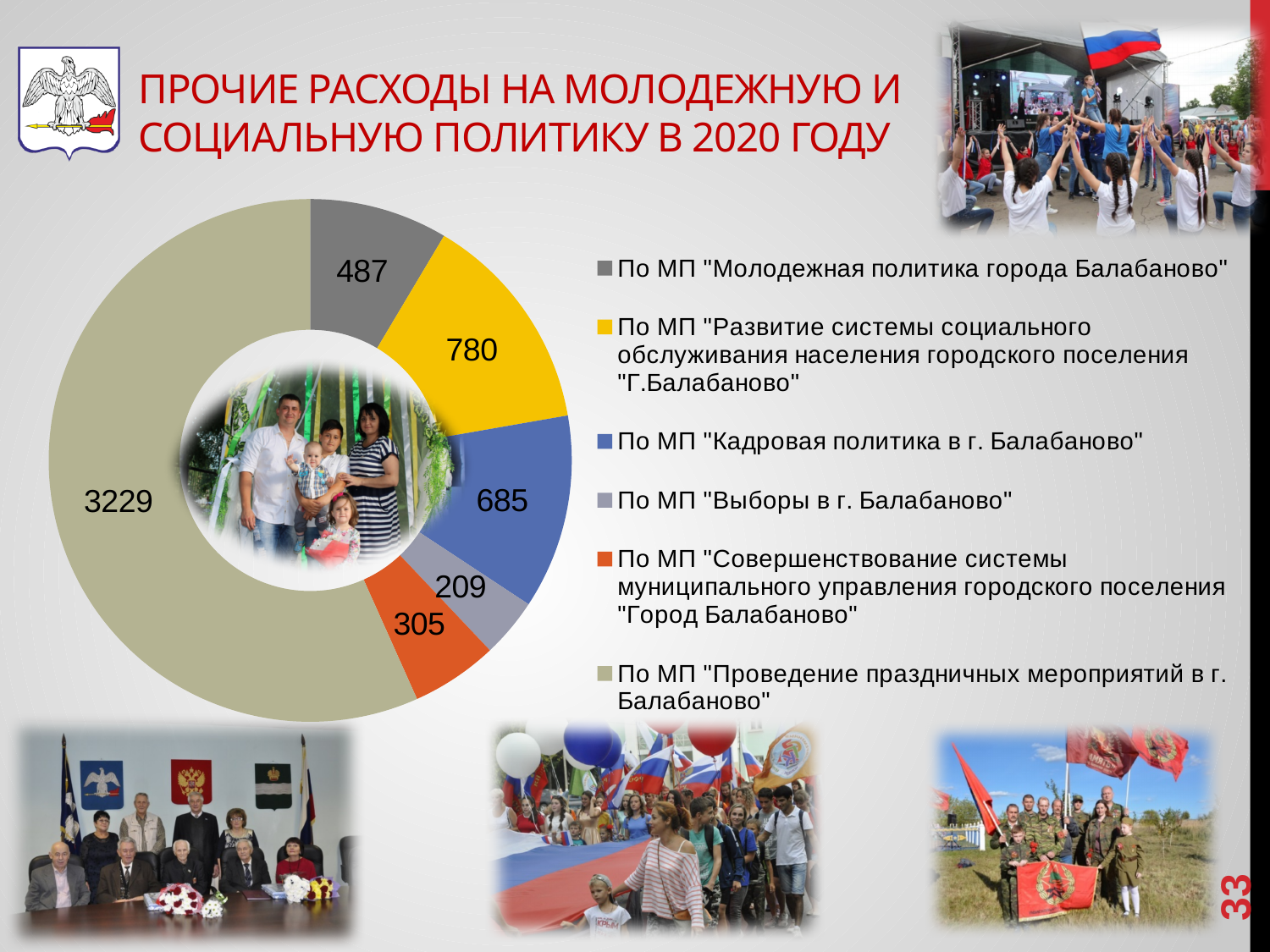
What is the value for the programme "Молодежная политика города Балабаново"? 487 What type of chart is shown on the slide? Doughnut (pie) chart What is the title of the slide containing the chart? ПРОЧИЕ РАСХОДЫ НА МОЛОДЕЖНУЮ И СОЦИАЛЬНУЮ ПОЛИТИКУ В 2020 ГОДУ What is the difference between the values for "Развитие системы социального обслуживания населения" (780) and "Кадровая политика" (685)? 95 Which programme has the largest value in the chart? По МП "Проведение праздничных мероприятий в г. Балабаново" Which programme has the smallest value in the chart? По МП "Выборы в г. Балабаново" What is the value for the programme "Выборы в г. Балабаново"? 209 What is the value for the programme "Кадровая политика в г. Балабаново"? 685 What is the value for the programme "Проведение праздничных мероприятий в г. Балабаново"? 3229 What is the total of all the values shown in the chart? 5695 Which is larger: the value for "Совершенствование системы муниципального управления" or the value for "Выборы в г. Балабаново"? Совершенствование системы муниципального управления (305) How many segments does the doughnut chart have? 6